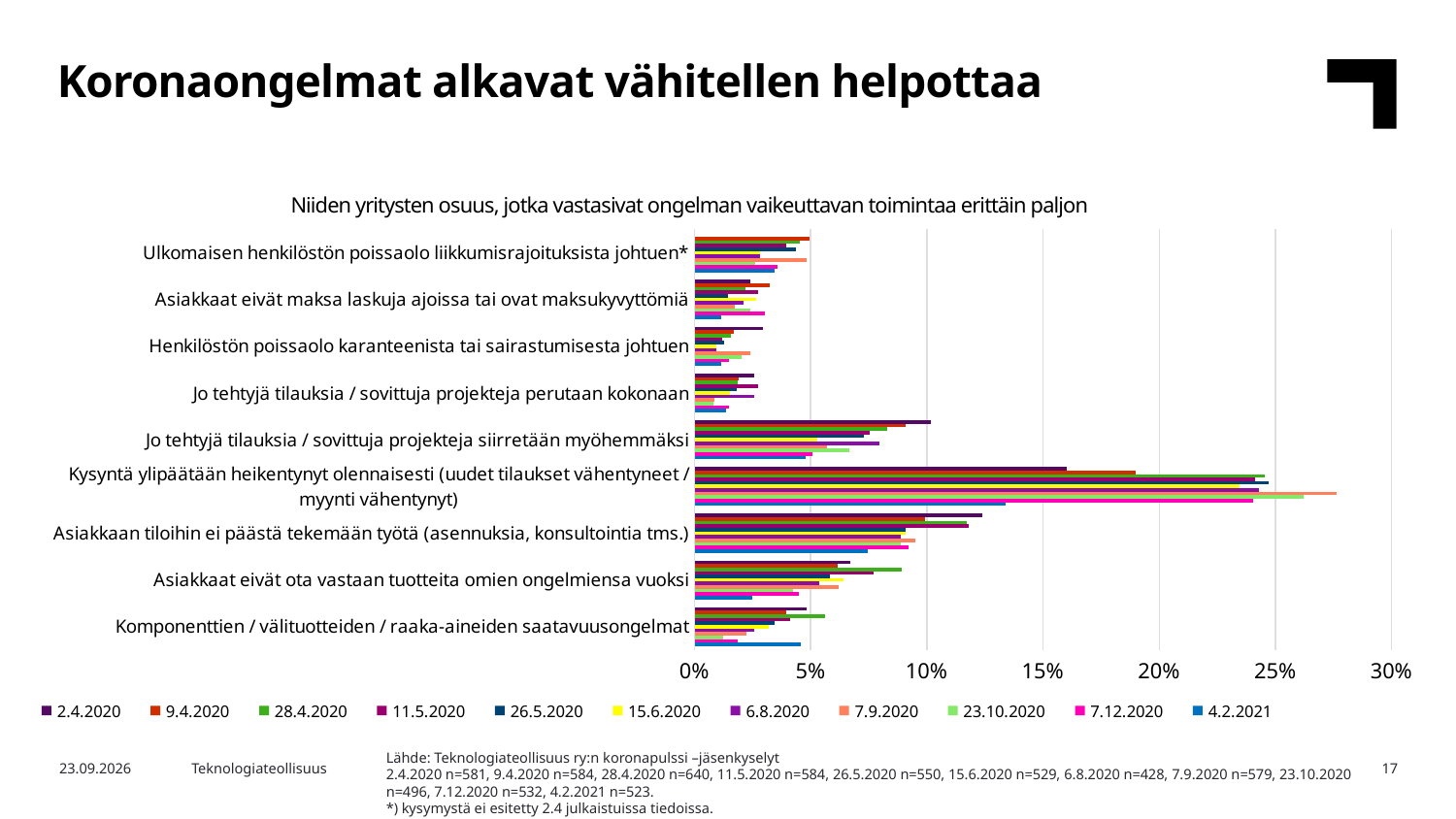
Is the 7.9.2020 value for 'Kysyntä ylipäätään heikentynyt olennaisesti' greater or less than 25%? greater For 'Komponenttien / välituotteiden / raaka-aineiden saatavuusongelmat', which is larger: the 7.12.2020 value or the 4.2.2021 value? 4.2.2021 Which category has the longest bars in the chart? Kysyntä ylipäätään heikentynyt olennaisesti (uudet tilaukset vähentyneet / myynti vähentynyt) What is the title of the chart? Niiden yritysten osuus, jotka vastasivat ongelman vaikeuttavan toimintaa erittäin paljon For 'Kysyntä ylipäätään heikentynyt olennaisesti', which is larger: the 7.9.2020 value or the 4.2.2021 value? 7.9.2020 Is the 4.2.2021 value for 'Komponenttien / välituotteiden / raaka-aineiden saatavuusongelmat' greater or less than 5%? less What is the highest value shown on the horizontal axis of the chart? 30% What kind of chart is shown on the slide? Bar chart Is the 2.4.2020 value for 'Asiakkaan tiloihin ei päästä tekemään työtä' greater or less than 10%? greater How many survey dates (series) does the chart legend list? 11 How many problem categories are listed on the vertical axis of the chart? 9